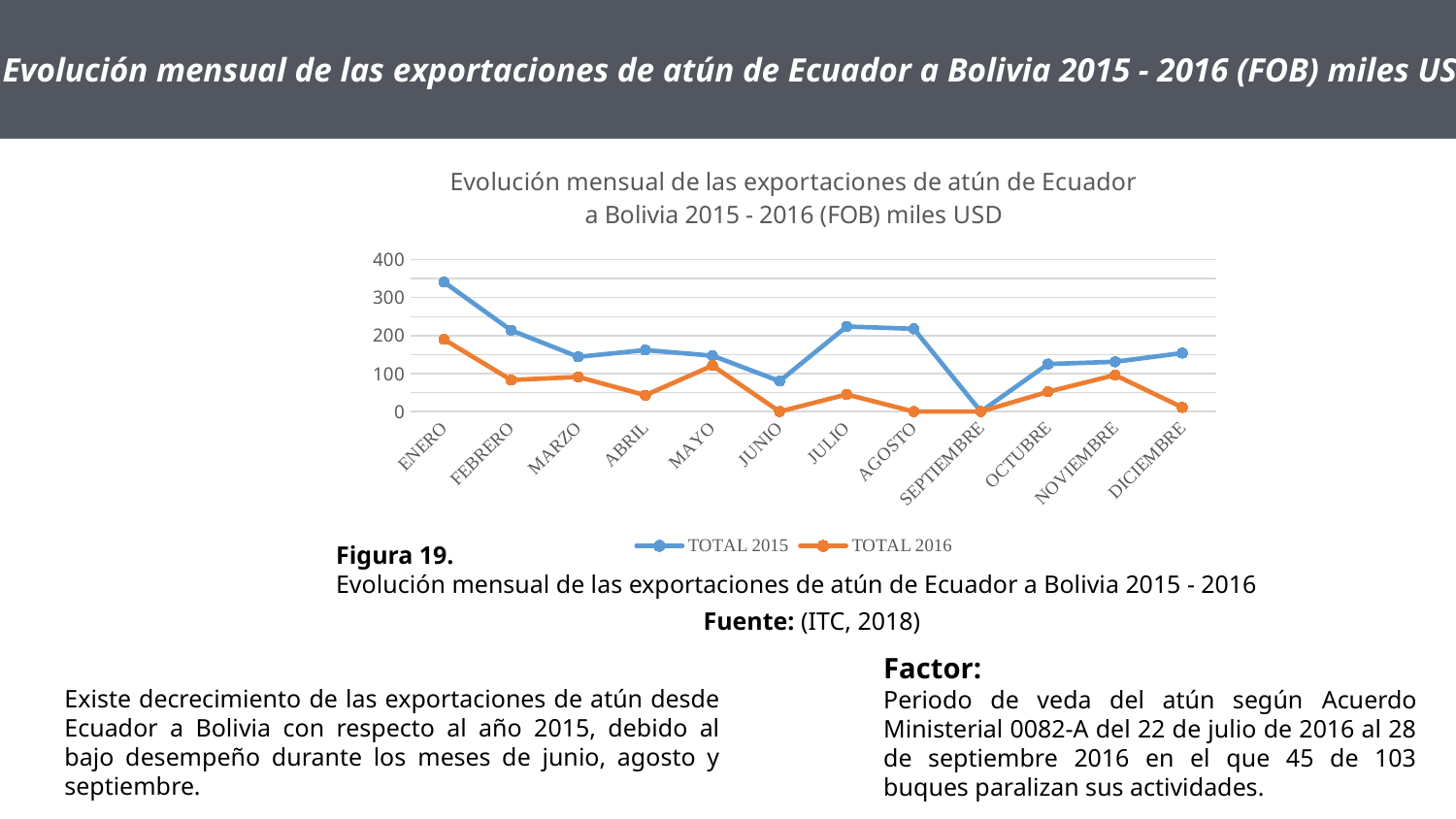
Which series is drawn in orange? TOTAL 2016 How many series does the legend list? 2 Is the TOTAL 2016 value for ABRIL greater or less than 100? less What is the highest value shown on the vertical axis? 400 How many months are plotted along the x axis? 12 Is the TOTAL 2015 value for ENERO greater or less than 300? greater Is the TOTAL 2015 value for JULIO greater or less than 200? greater What kind of chart is shown on the slide? line chart In which month is the TOTAL 2015 series at its highest? ENERO In which month is the TOTAL 2016 series at its highest? ENERO Which series has the larger value in FEBRERO, TOTAL 2015 or TOTAL 2016? TOTAL 2015 Does the TOTAL 2015 series rise or fall from ENERO to MARZO? fall